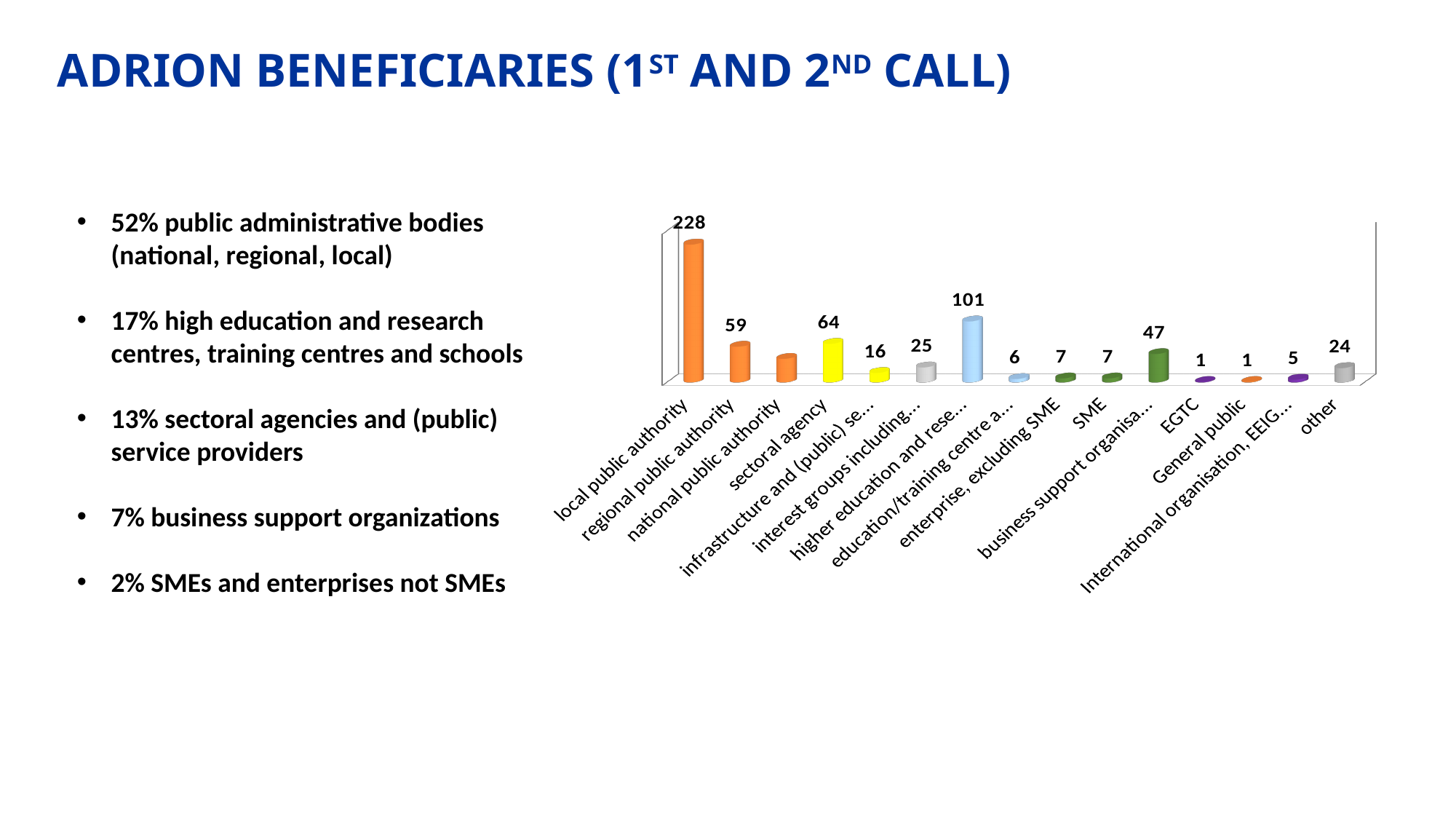
How many categories are shown on the x axis of the chart? 15 What is the difference between the value for local public authority and the value for the higher education and research bar? 127 What is the value for EGTC? 1 What is the value for the 'other' category? 24 What is the value for SME? 7 What is the value for regional public authority? 59 What is the value for sectoral agency? 64 What is the value for local public authority? 228 What is the difference between the value for the business support organisation bar and the value for 'other'? 23 Which is larger, the value for sectoral agency or the value for regional public authority? sectoral agency Which category has the highest value? local public authority What kind of chart is shown on the slide? bar chart